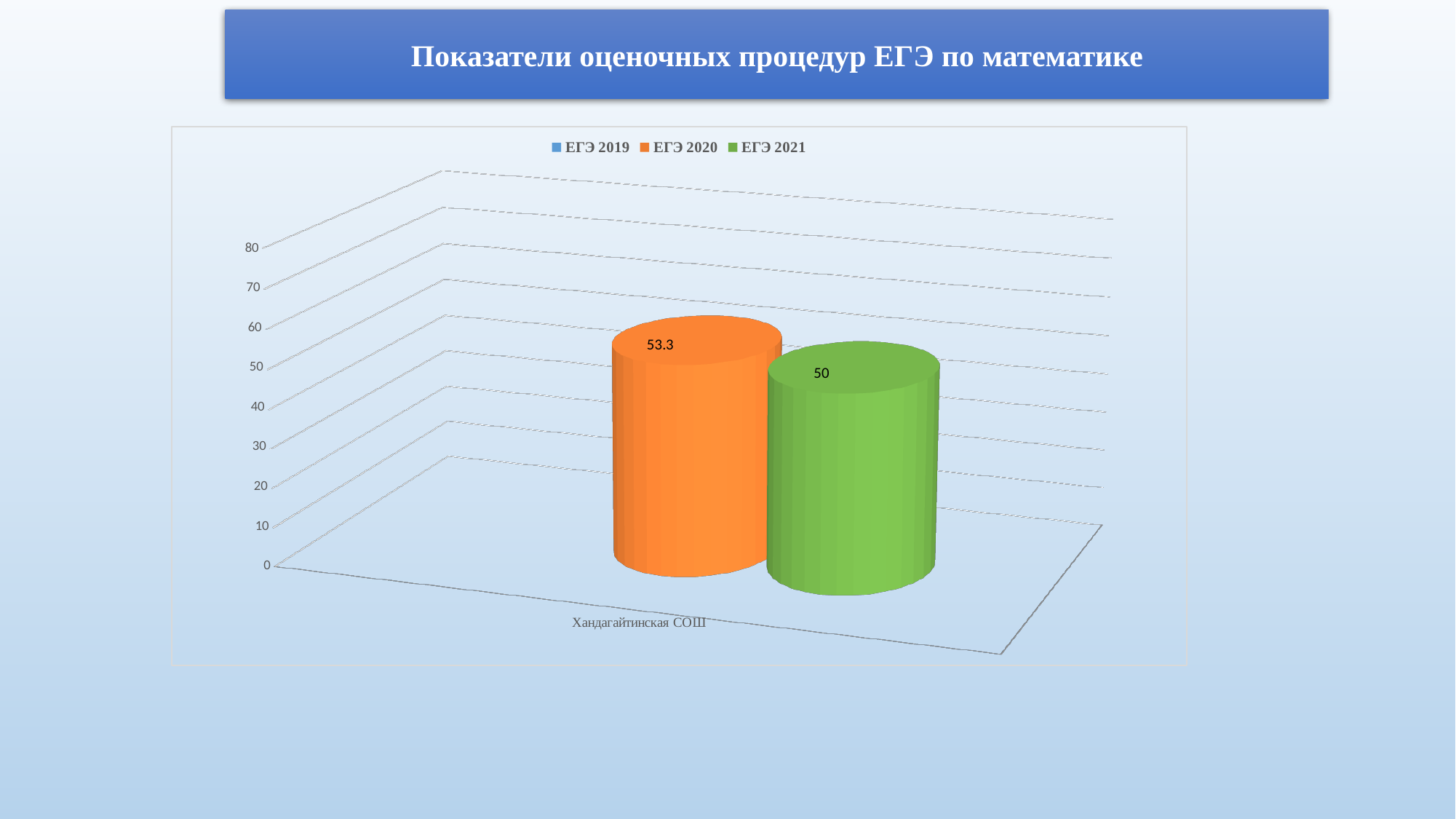
How many categories are shown on the x axis? 1 What is the title of the slide? Показатели оценочных процедур ЕГЭ по математике What colour represents ЕГЭ 2021 in the legend? green Which is larger, the value for ЕГЭ 2020 or the value for ЕГЭ 2021? ЕГЭ 2020 What is the value for ЕГЭ 2020 for Хандагайтинская СОШ? 53.3 Which series has the highest plotted value? ЕГЭ 2020 How many series does the legend list? 3 What is the value for ЕГЭ 2021 for Хандагайтинская СОШ? 50 Is the value for ЕГЭ 2020 greater or less than 40? greater What is the difference between the ЕГЭ 2020 and ЕГЭ 2021 values? 3.3 What kind of chart is shown on the slide? bar chart Is the value for ЕГЭ 2021 greater or less than 60? less